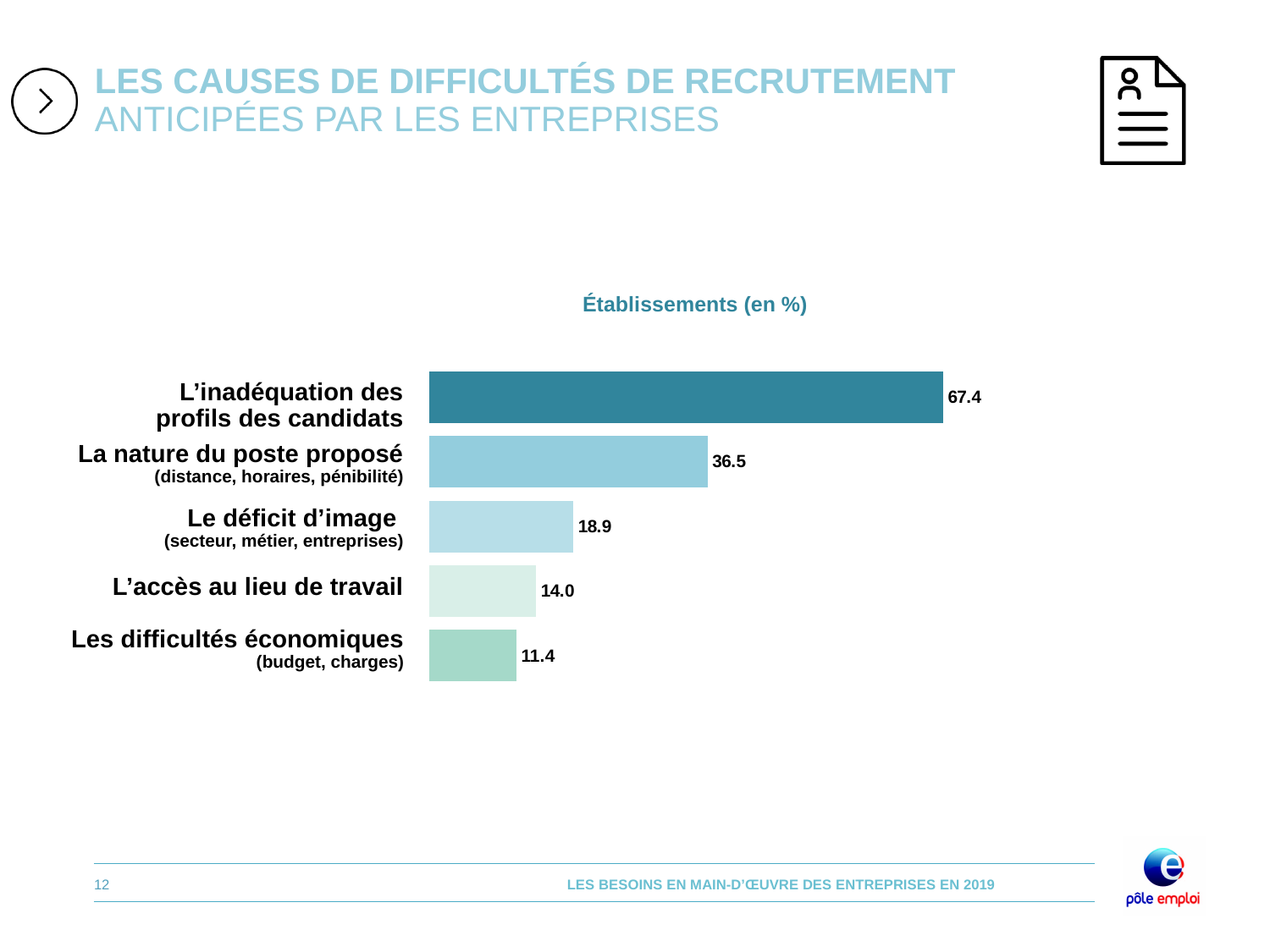
What kind of chart is shown on the slide? Bar chart How many categories are shown in the chart? 5 What is the value for "L'inadéquation des profils des candidats"? 67.4 Which category has the lowest value? Les difficultés économiques What is the difference between the values for "L'inadéquation des profils des candidats" and "La nature du poste proposé"? 30.9 Which is larger: the value for "Le déficit d'image" or the value for "L'accès au lieu de travail"? Le déficit d'image What is the value for "Le déficit d'image"? 18.9 What is the value for "Les difficultés économiques"? 11.4 What is the title of the chart? Établissements (en %) What is the value for "L'accès au lieu de travail"? 14.0 Which category has the highest value? L'inadéquation des profils des candidats What is the value for "La nature du poste proposé"? 36.5